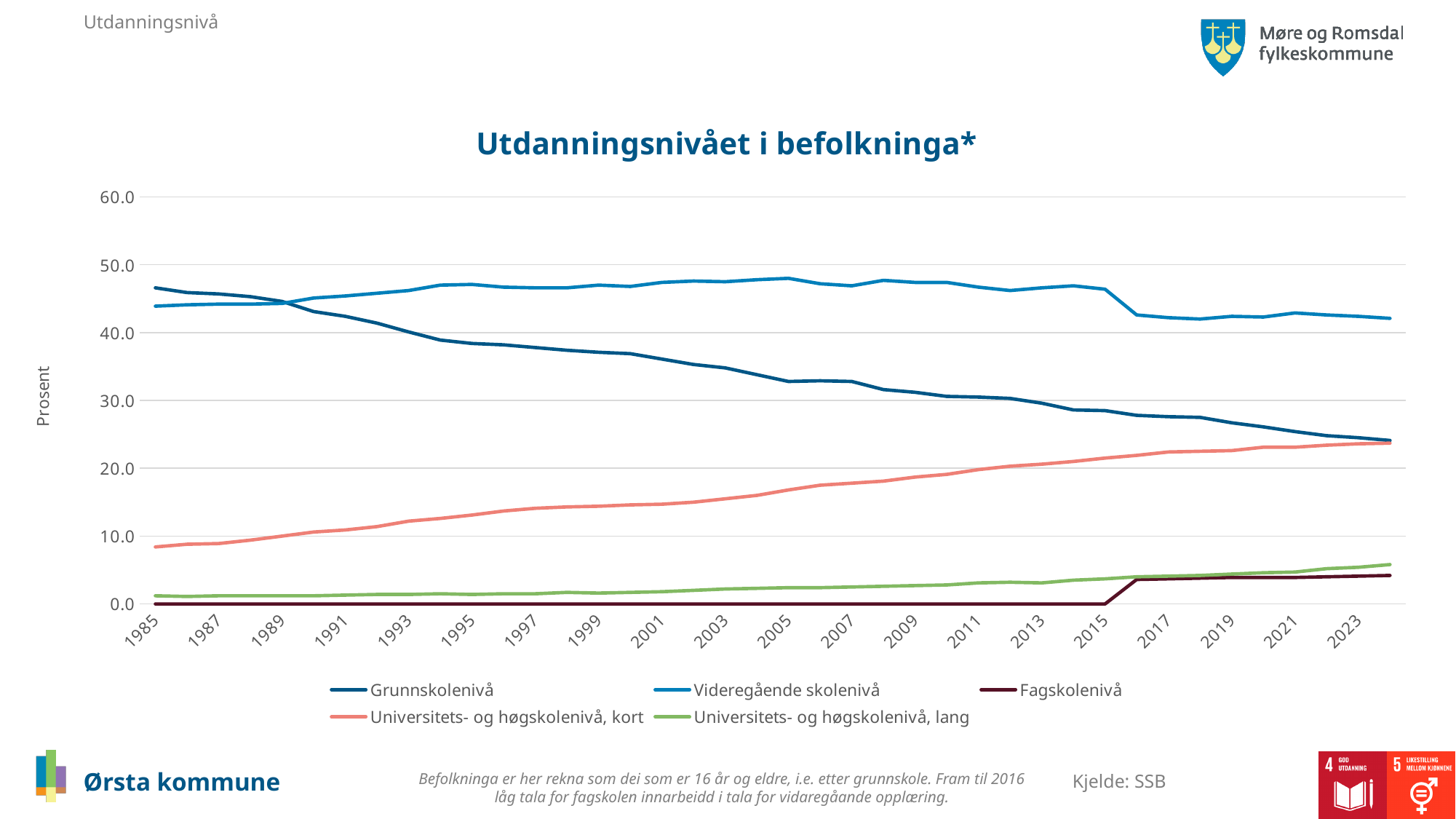
Is the value for Grunnskolenivå in 1985 greater or less than 40? greater Which series has the lowest value in 2010? Fagskolenivå Does the Grunnskolenivå line rise or fall from 1985 to 2023? fall Is the value for Videregående skolenivå in 2023 greater or less than 40? greater How many series does the legend list? 5 Is the value for Grunnskolenivå in 2023 greater or less than 30? less Which series has the highest value in 2005? Videregående skolenivå What is the title of the chart? Utdanningsnivået i befolkninga* What is the label on the vertical axis? Prosent What kind of chart is shown on the slide? line chart Does the Universitets- og høgskolenivå, kort line rise or fall from 1985 to 2023? rise